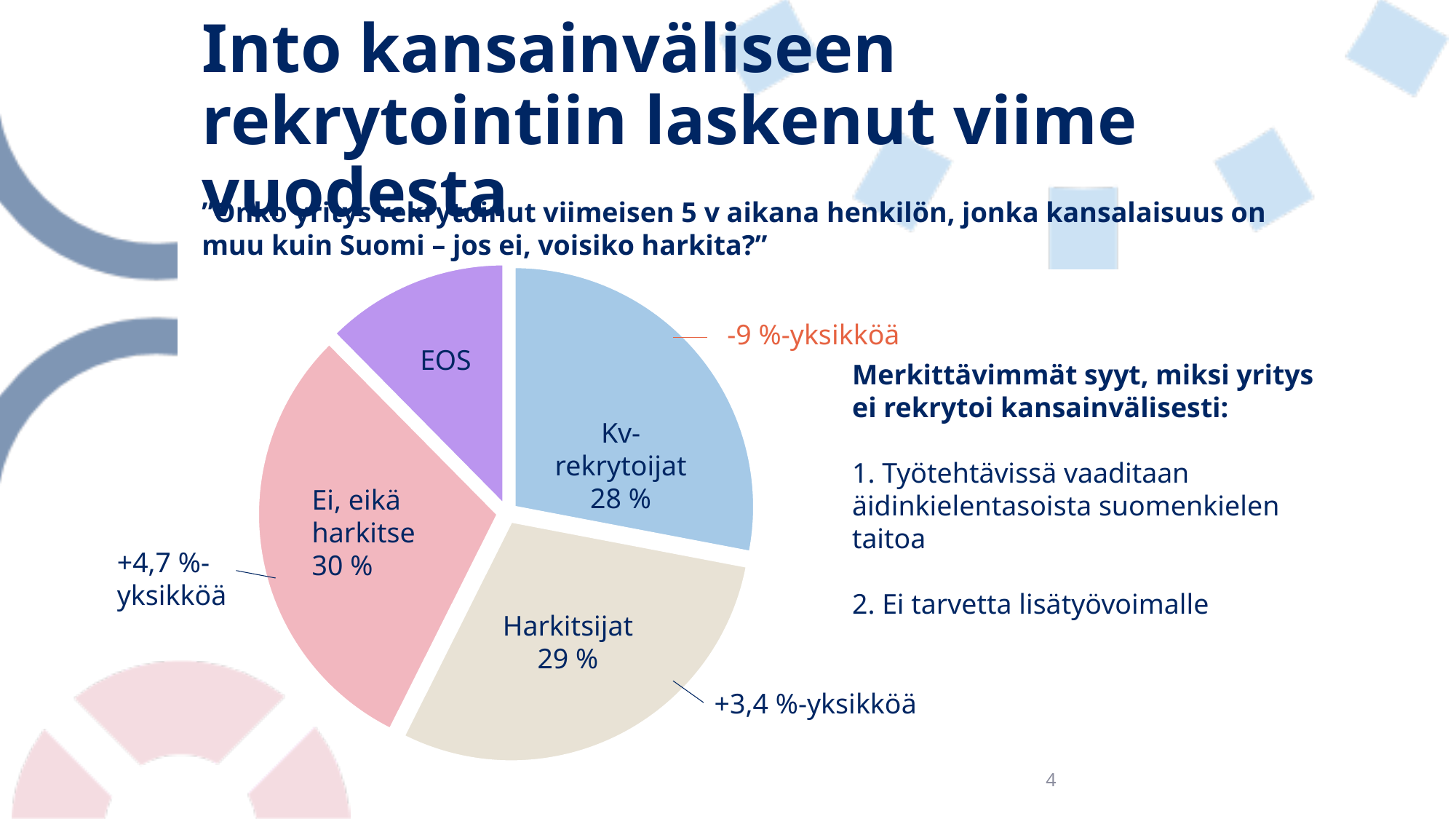
Which slice of the pie chart is the smallest? EOS What change annotation is shown next to the Harkitsijat slice? +3,4 %-yksikköä What is the value shown for the Kv-rekrytoijat slice? 28 % What kind of chart is shown on the slide? pie chart Which slice of the pie chart is the largest? Ei, eikä harkitse Which is larger, the Harkitsijat slice or the Kv-rekrytoijat slice? Harkitsijat How many slices does the pie chart have? 4 What change annotation is shown next to the Kv-rekrytoijat slice? -9 %-yksikköä What is the difference in percentage points between the 'Ei, eikä harkitse' slice and the Kv-rekrytoijat slice? 2 What is the value shown for the Harkitsijat slice? 29 % What is the value shown for the 'Ei, eikä harkitse' slice? 30 %